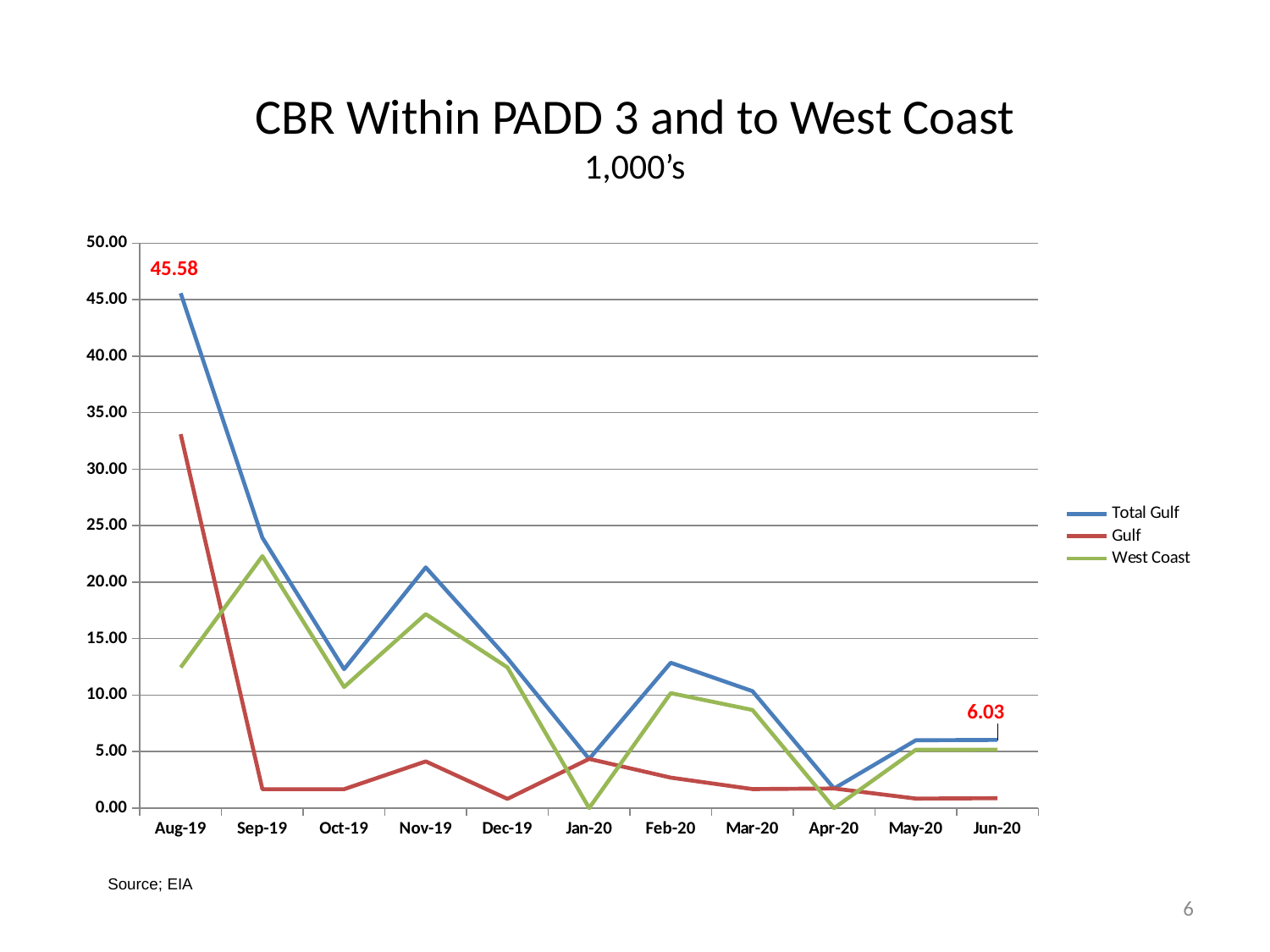
Is the Gulf value for Aug-19 greater or less than 30.00? greater What is the Total Gulf value for Aug-19? 45.58 How many series does the legend list? 3 How many months are plotted along the x axis? 11 In Sep-19, which is larger: the Gulf value or the West Coast value? West Coast What kind of chart is shown on the slide? line chart What is the title of the chart? CBR Within PADD 3 and to West Coast What is the difference between the Total Gulf values for Aug-19 and Jun-20? 39.55 What is the Total Gulf value for Jun-20? 6.03 Is the West Coast value for Sep-19 greater or less than 20.00? greater Does the Total Gulf series rise or fall overall from Aug-19 to Jun-20? fall In which month is the Total Gulf series highest? Aug-19